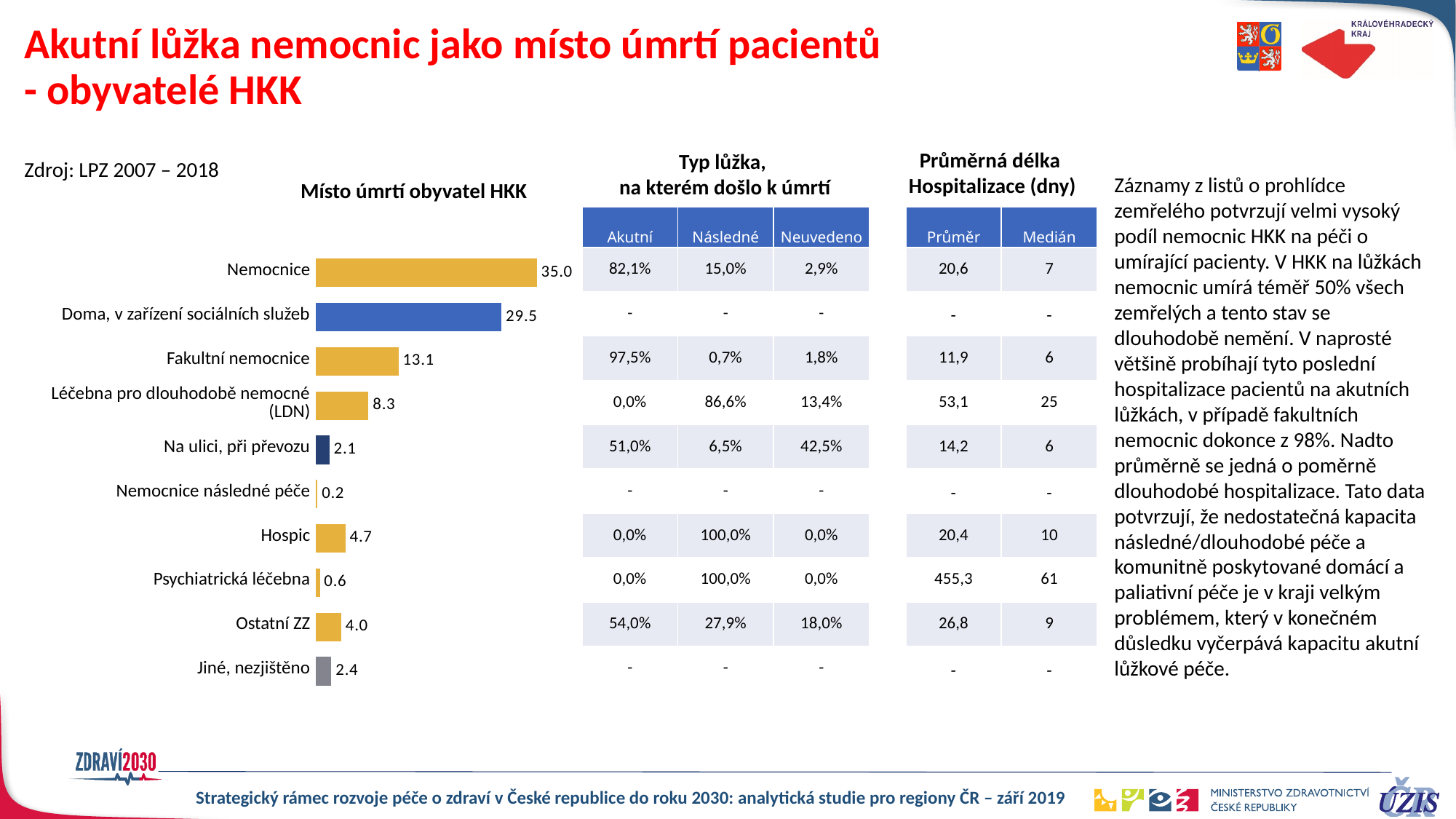
In the "Místo úmrtí obyvatel HKK" chart, what is the difference between the values for Nemocnice and Doma, v zařízení sociálních služeb? 5.5 In the "Místo úmrtí obyvatel HKK" chart, which is larger: Fakultní nemocnice or Léčebna pro dlouhodobě nemocné (LDN)? Fakultní nemocnice Which category has the highest value in the "Místo úmrtí obyvatel HKK" chart? Nemocnice Which category has the lowest value in the "Místo úmrtí obyvatel HKK" chart? Nemocnice následné péče In the "Místo úmrtí obyvatel HKK" chart, what is the value for Nemocnice? 35.0 In the "Místo úmrtí obyvatel HKK" chart, what is the value for Hospic? 4.7 What is the title of the bar chart on the slide? Místo úmrtí obyvatel HKK In the "Místo úmrtí obyvatel HKK" chart, what is the difference between the values for Hospic and Ostatní ZZ? 0.7 In the "Místo úmrtí obyvatel HKK" chart, what is the value for Doma, v zařízení sociálních služeb? 29.5 How many categories are shown in the "Místo úmrtí obyvatel HKK" chart? 10 What type of chart is "Místo úmrtí obyvatel HKK"? bar chart In the "Místo úmrtí obyvatel HKK" chart, what is the value for Léčebna pro dlouhodobě nemocné (LDN)? 8.3